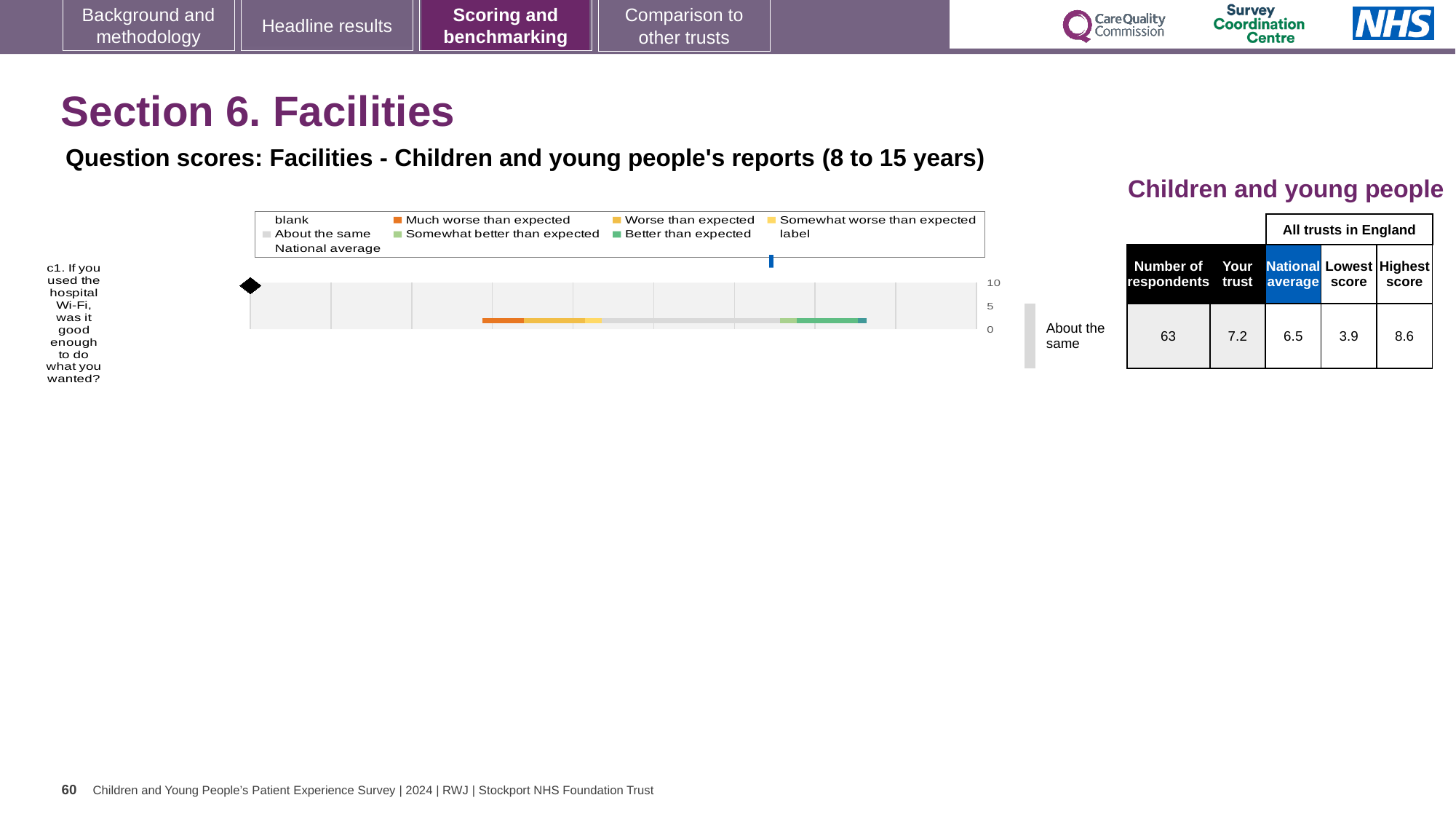
Which is larger for question c1: the trust's score or the national average? Your trust What is the national average score for question c1 about hospital Wi-Fi? 6.5 What is the 'Your trust' score for question c1 about hospital Wi-Fi? 7.2 What is the lowest score among all trusts in England for question c1? 3.9 What is the difference between the highest and lowest scores across all trusts in England for question c1? 4.7 What is the highest score among all trusts in England for question c1? 8.6 How many questions (categories) are plotted in the chart? 1 What is the highest tick value shown on the chart's axis? 10 Which question is plotted in the chart? c1. If you used the hospital Wi-Fi, was it good enough to do what you wanted? How many respondents answered question c1 about hospital Wi-Fi? 63 What is the difference between the trust's score and the national average for question c1? 0.7 What kind of chart is shown on the slide? bar chart